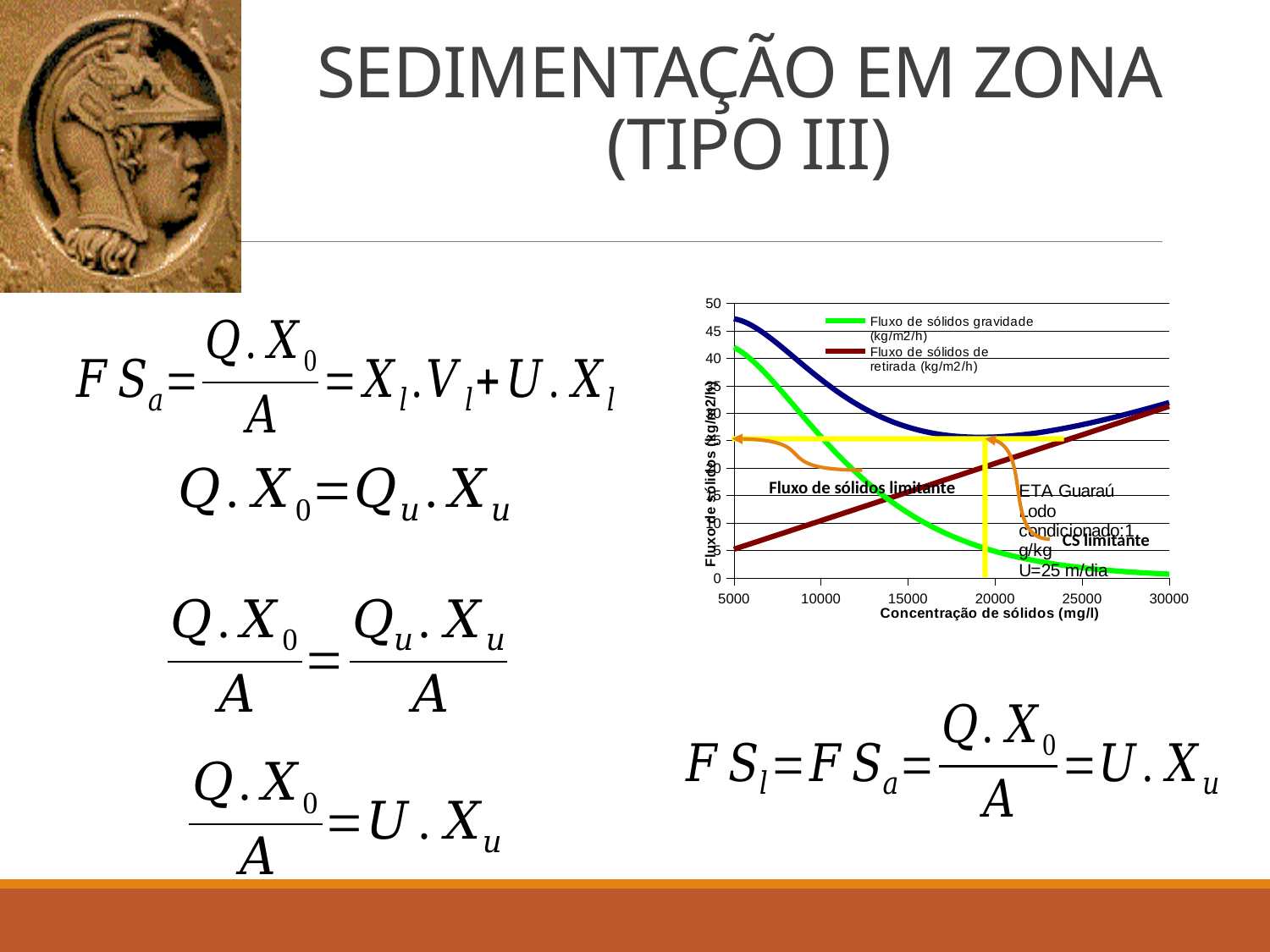
At a concentration of 30000 mg/l, which series has the larger value: 'Fluxo de sólidos gravidade (kg/m2/h)' or 'Fluxo de sólidos de retirada (kg/m2/h)'? Fluxo de sólidos de retirada (kg/m2/h) Is the value of 'Fluxo de sólidos gravidade (kg/m2/h)' at a concentration of 5000 mg/l greater or less than 40? greater How many series does the chart legend list? 2 Is the value of 'Fluxo de sólidos gravidade (kg/m2/h)' at a concentration of 30000 mg/l greater or less than 5? less At a concentration of 5000 mg/l, which series has the larger value: 'Fluxo de sólidos gravidade (kg/m2/h)' or 'Fluxo de sólidos de retirada (kg/m2/h)'? Fluxo de sólidos gravidade (kg/m2/h) What is the title of the x axis of the chart? Concentração de sólidos (mg/l) Does the 'Fluxo de sólidos de retirada (kg/m2/h)' line rise or fall as the solids concentration increases along the x axis? rise Is the value of 'Fluxo de sólidos de retirada (kg/m2/h)' at a concentration of 5000 mg/l greater or less than 10? less Which colour is used for the 'Fluxo de sólidos gravidade (kg/m2/h)' series in the legend? green Does the 'Fluxo de sólidos gravidade (kg/m2/h)' line rise or fall as the solids concentration increases along the x axis? fall What kind of chart is shown on the slide? line chart